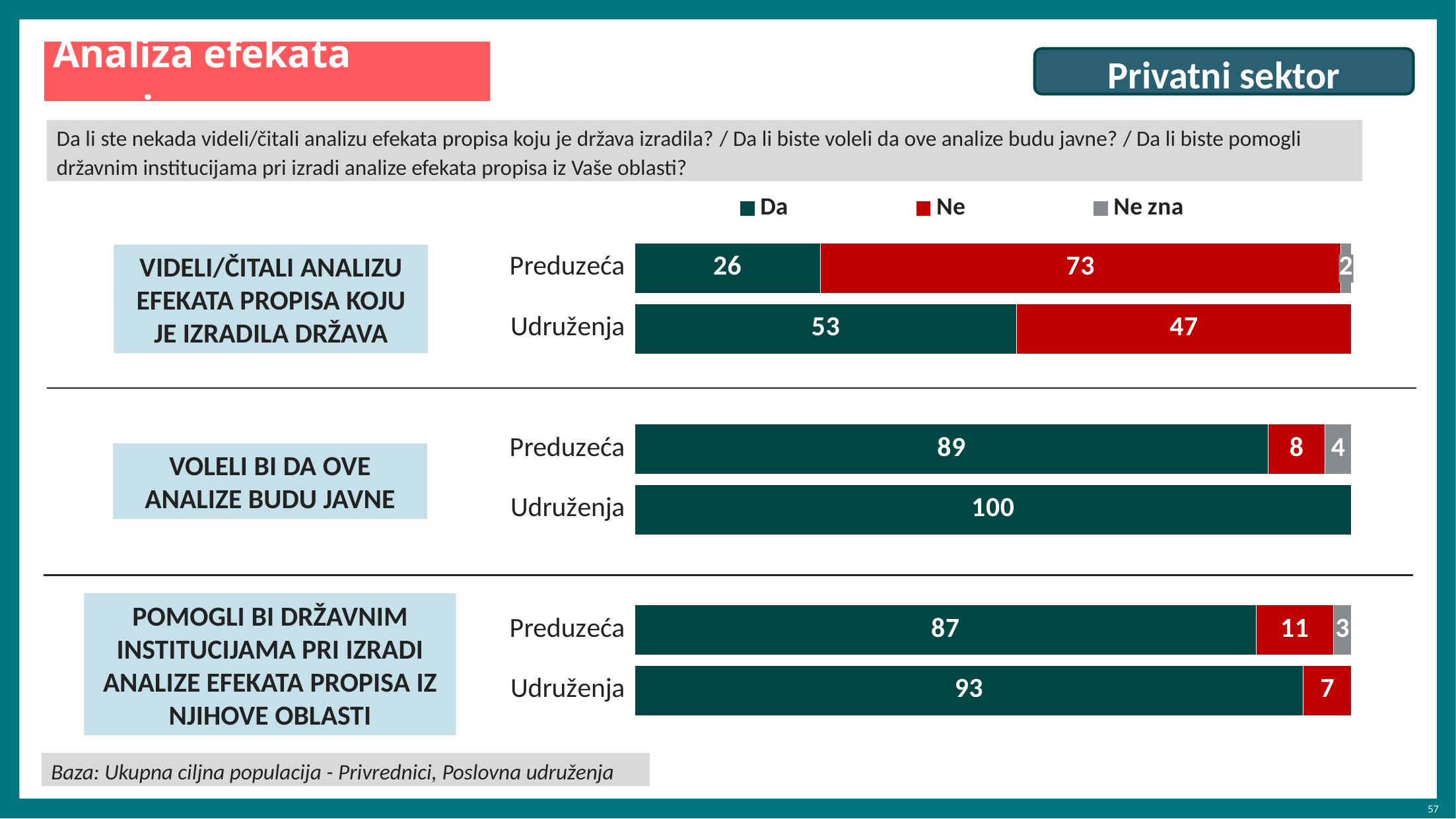
In the chart 'POMOGLI BI DRŽAVNIM INSTITUCIJAMA PRI IZRADI ANALIZE EFEKATA PROPISA IZ NJIHOVE OBLASTI', what is the difference between the 'Da' values for Udruženja and Preduzeća? 6 In the chart 'VOLELI BI DA OVE ANALIZE BUDU JAVNE', what is the total of the stacked bar for Preduzeća? 101 In the chart 'VIDELI/ČITALI ANALIZU EFEKATA PROPISA KOJU JE IZRADILA DRŽAVA', what is the 'Da' value for Preduzeća? 26 How many series does the legend list? 3 In the chart 'VIDELI/ČITALI ANALIZU EFEKATA PROPISA KOJU JE IZRADILA DRŽAVA', what is the difference between the 'Ne' values for Preduzeća and Udruženja? 26 In the chart 'VIDELI/ČITALI ANALIZU EFEKATA PROPISA KOJU JE IZRADILA DRŽAVA', which group has the higher 'Da' value, Preduzeća or Udruženja? Udruženja In the chart 'VIDELI/ČITALI ANALIZU EFEKATA PROPISA KOJU JE IZRADILA DRŽAVA', what is the 'Ne' value for Udruženja? 47 Which legend entry is shown in red? Ne In the chart 'POMOGLI BI DRŽAVNIM INSTITUCIJAMA PRI IZRADI ANALIZE EFEKATA PROPISA IZ NJIHOVE OBLASTI', what is the 'Ne' value for Preduzeća? 11 In the chart 'VOLELI BI DA OVE ANALIZE BUDU JAVNE', what is the 'Ne zna' value for Preduzeća? 4 What kind of chart is used on this slide? Stacked bar chart In the chart 'VOLELI BI DA OVE ANALIZE BUDU JAVNE', what is the 'Da' value for Udruženja? 100